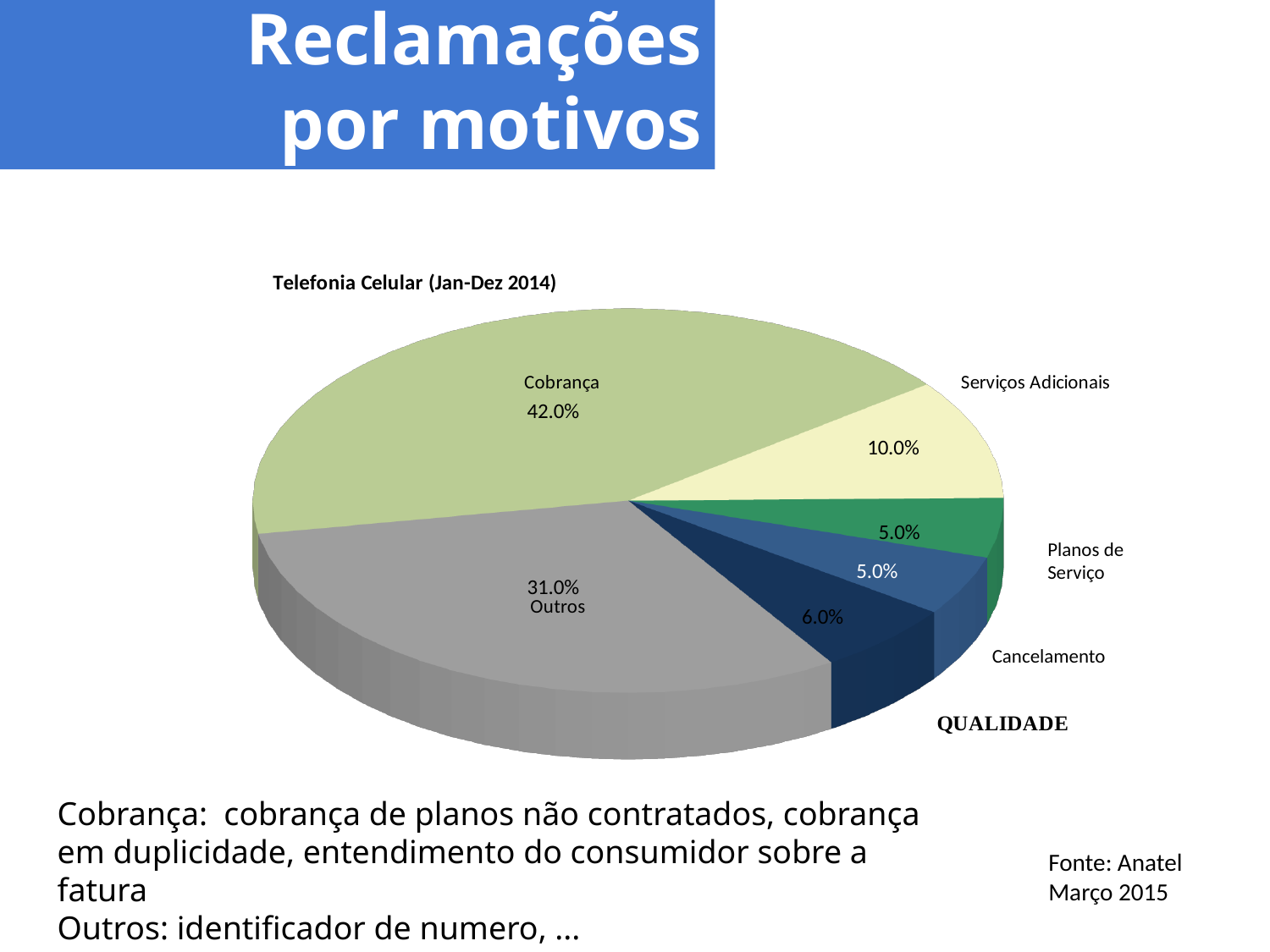
What is the combined share of Cobrança and Outros? 73.0% What kind of chart is shown on the slide? Pie chart Which slice is larger, Serviços Adicionais or QUALIDADE? Serviços Adicionais What share of complaints is attributed to Outros? 31.0% What share of complaints is attributed to Cancelamento? 5.0% What share of complaints is attributed to QUALIDADE? 6.0% How many slices does the pie chart have? 6 Which category has the largest slice of the pie? Cobrança What share of complaints is attributed to Serviços Adicionais? 10.0% What is the title of the chart? Telefonia Celular (Jan-Dez 2014) How many percentage points larger is the Cobrança slice than the Outros slice? 11.0 What share of complaints is attributed to Cobrança? 42.0%